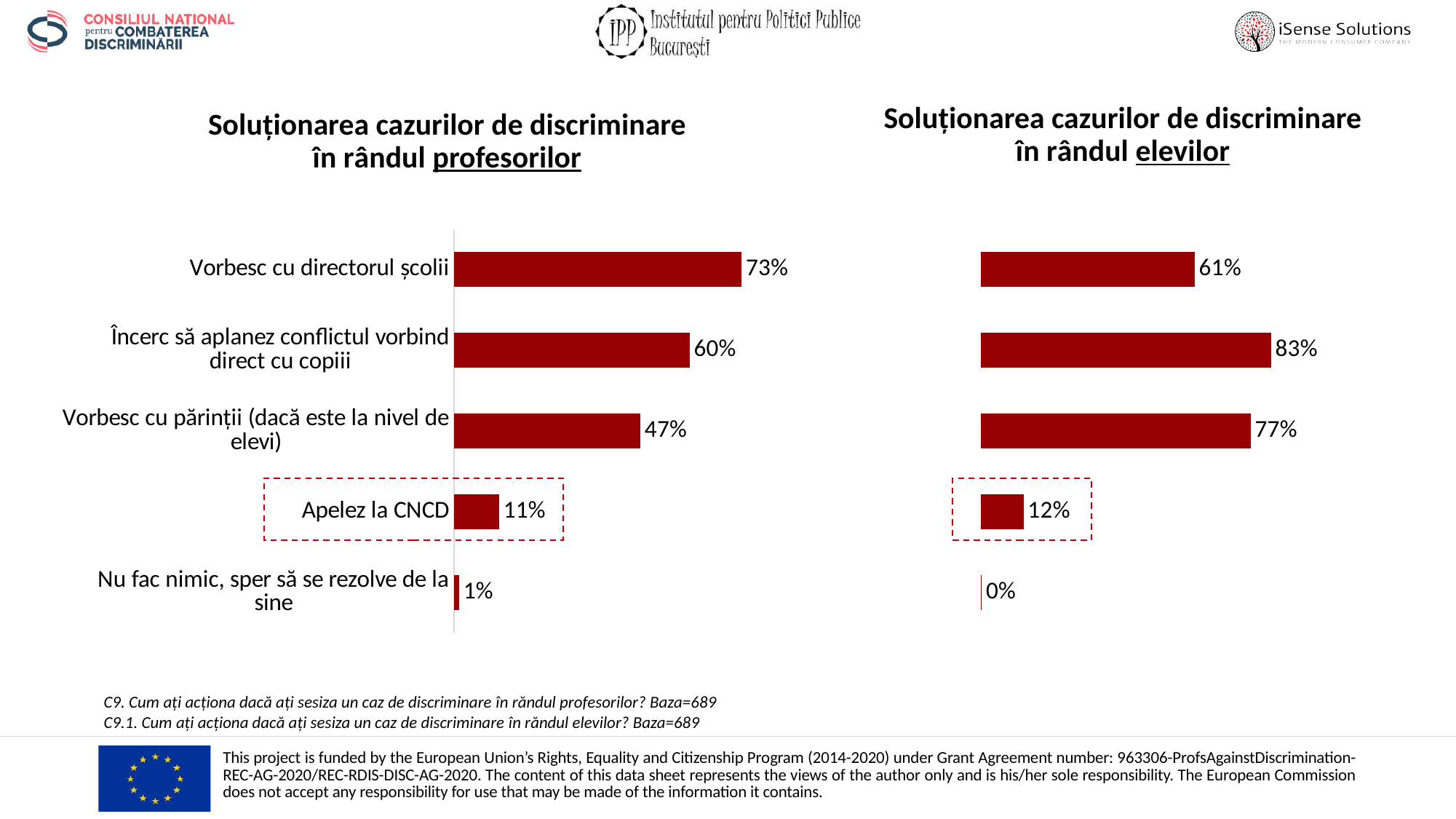
In the chart 'Soluționarea cazurilor de discriminare în rândul elevilor', what is the difference between 'Vorbesc cu părinții (dacă este la nivel de elevi)' and 'Vorbesc cu directorul școlii'? 16% In the chart 'Soluționarea cazurilor de discriminare în rândul profesorilor', what is the value for 'Apelez la CNCD'? 11% In the chart 'Soluționarea cazurilor de discriminare în rândul elevilor', which category has the highest value? Încerc să aplanez conflictul vorbind direct cu copiii In the chart 'Soluționarea cazurilor de discriminare în rândul elevilor', what is the value for 'Încerc să aplanez conflictul vorbind direct cu copiii'? 83% In the chart 'Soluționarea cazurilor de discriminare în rândul profesorilor', which category has the highest value? Vorbesc cu directorul școlii In the chart 'Soluționarea cazurilor de discriminare în rândul profesorilor', what is the value for 'Vorbesc cu directorul școlii'? 73% In the chart 'Soluționarea cazurilor de discriminare în rândul profesorilor', what is the difference between 'Vorbesc cu directorul școlii' and 'Vorbesc cu părinții (dacă este la nivel de elevi)'? 26% Which is larger: 'Apelez la CNCD' in the profesorilor chart or 'Apelez la CNCD' in the elevilor chart? elevilor chart (12%) What type of chart is 'Soluționarea cazurilor de discriminare în rândul elevilor'? Bar chart How many categories are shown in the chart 'Soluționarea cazurilor de discriminare în rândul profesorilor'? 5 In the chart 'Soluționarea cazurilor de discriminare în rândul profesorilor', which category has the lowest value? Nu fac nimic, sper să se rezolve de la sine In the chart 'Soluționarea cazurilor de discriminare în rândul elevilor', what is the value for 'Nu fac nimic, sper să se rezolve de la sine'? 0%